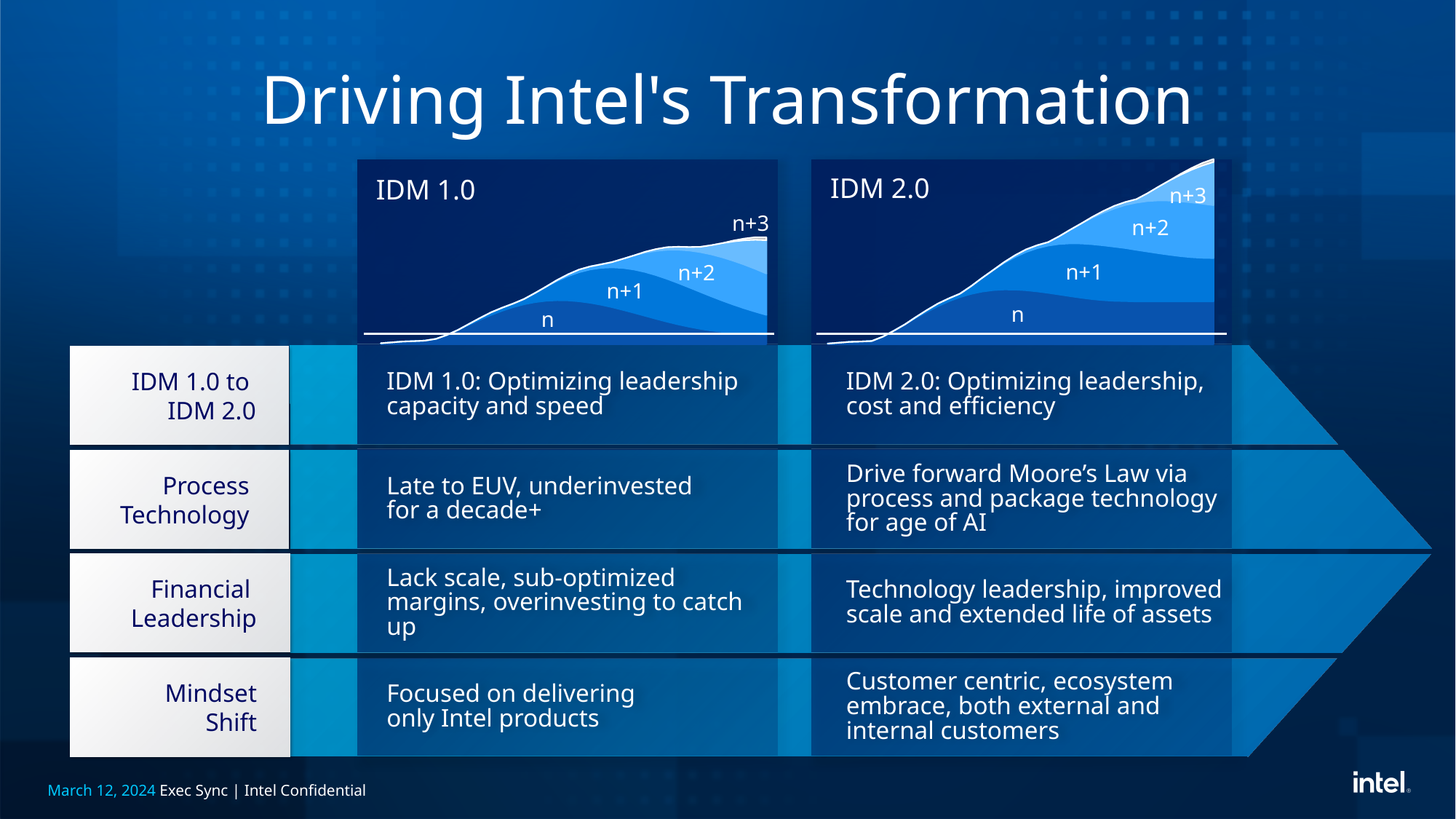
In the IDM 2.0 chart, which layer is at the bottom of the stack? n In the IDM 2.0 chart, how many labelled layers (series) are shown? 4 In the IDM 2.0 chart, does the total stacked value rise or fall from left to right? Rise What kind of chart is the IDM 1.0 chart? Stacked area chart How many charts are shown on the slide? 2 In the IDM 1.0 chart, does the total stacked value rise or fall from left to right? Rise In the IDM 1.0 chart, what are the labels of the stacked layers from bottom to top? n, n+1, n+2, n+3 What is the title of the chart on the left? IDM 1.0 In the IDM 1.0 chart, how many labelled layers (series) are shown? 4 What kind of chart is the IDM 2.0 chart? Stacked area chart Which chart reaches a higher total at its right-hand end, IDM 1.0 or IDM 2.0? IDM 2.0